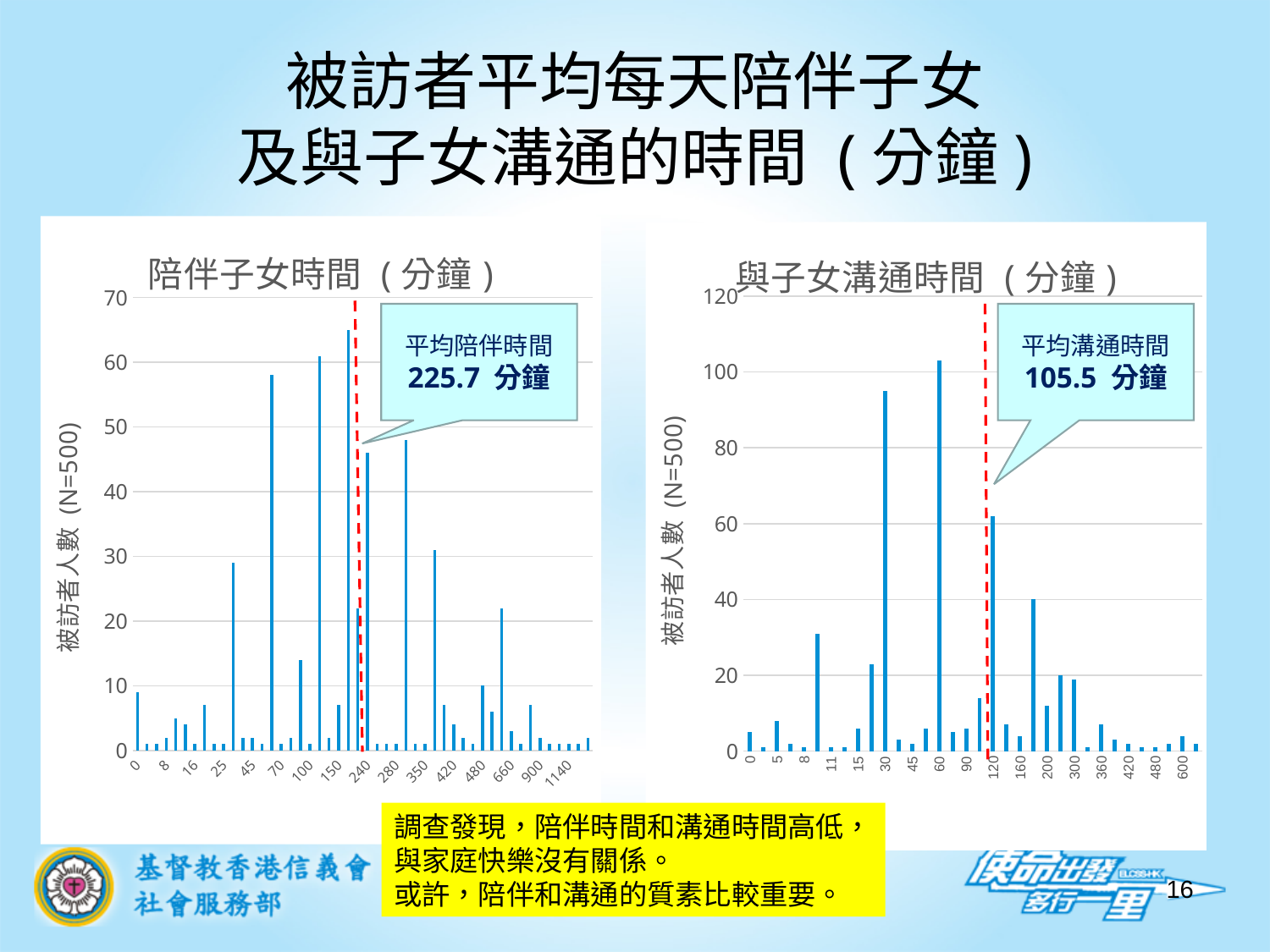
In the right chart 與子女溝通時間（分鐘）, is the number of respondents at 8 minutes greater or less than 40? less In the right chart 與子女溝通時間（分鐘）, is the number of respondents at 60 minutes greater or less than 80? greater In the right chart 與子女溝通時間（分鐘）, which of 30 minutes or 60 minutes has more respondents? 60 What is the y-axis label of the left chart 陪伴子女時間（分鐘）? 被訪者人數（N=500） What kind of chart is the right chart titled 與子女溝通時間（分鐘）? bar chart In the left chart 陪伴子女時間（分鐘）, is the number of respondents at 100 minutes greater or less than 50? less In the left chart 陪伴子女時間（分鐘）, what is the average accompanying time shown in the callout? 225.7 分鐘 In the right chart 與子女溝通時間（分鐘）, what is the average communication time shown in the callout? 105.5 分鐘 How many charts are shown on the slide? 2 What kind of chart is the left chart titled 陪伴子女時間（分鐘）? bar chart